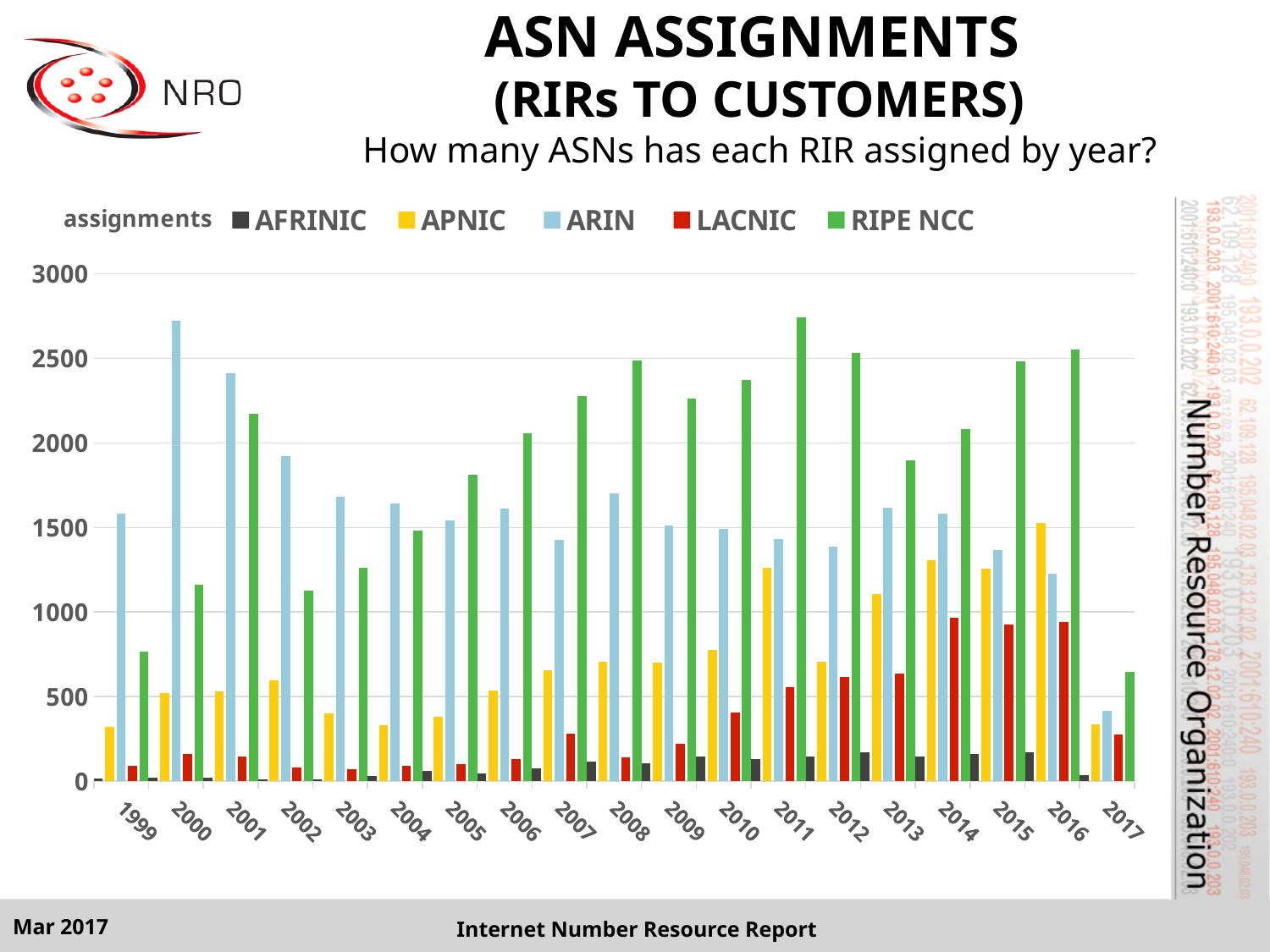
Is the value for ARIN in 2017 greater or less than 500? less In which year does ARIN have its highest value? 2000 How many series does the legend list? 5 Do the ARIN values rise or fall from 2000 to 2003? fall How many years are shown along the x axis? 19 Is the value for ARIN in 2000 greater or less than 2500? greater Is the value for RIPE NCC in 1999 greater or less than 1000? less What kind of chart is shown on the slide? bar chart In 2016, which is larger, the value for RIPE NCC or the value for ARIN? RIPE NCC In 2000, which is larger, the value for ARIN or the value for RIPE NCC? ARIN Which RIR has the lowest value in 2017? AFRINIC